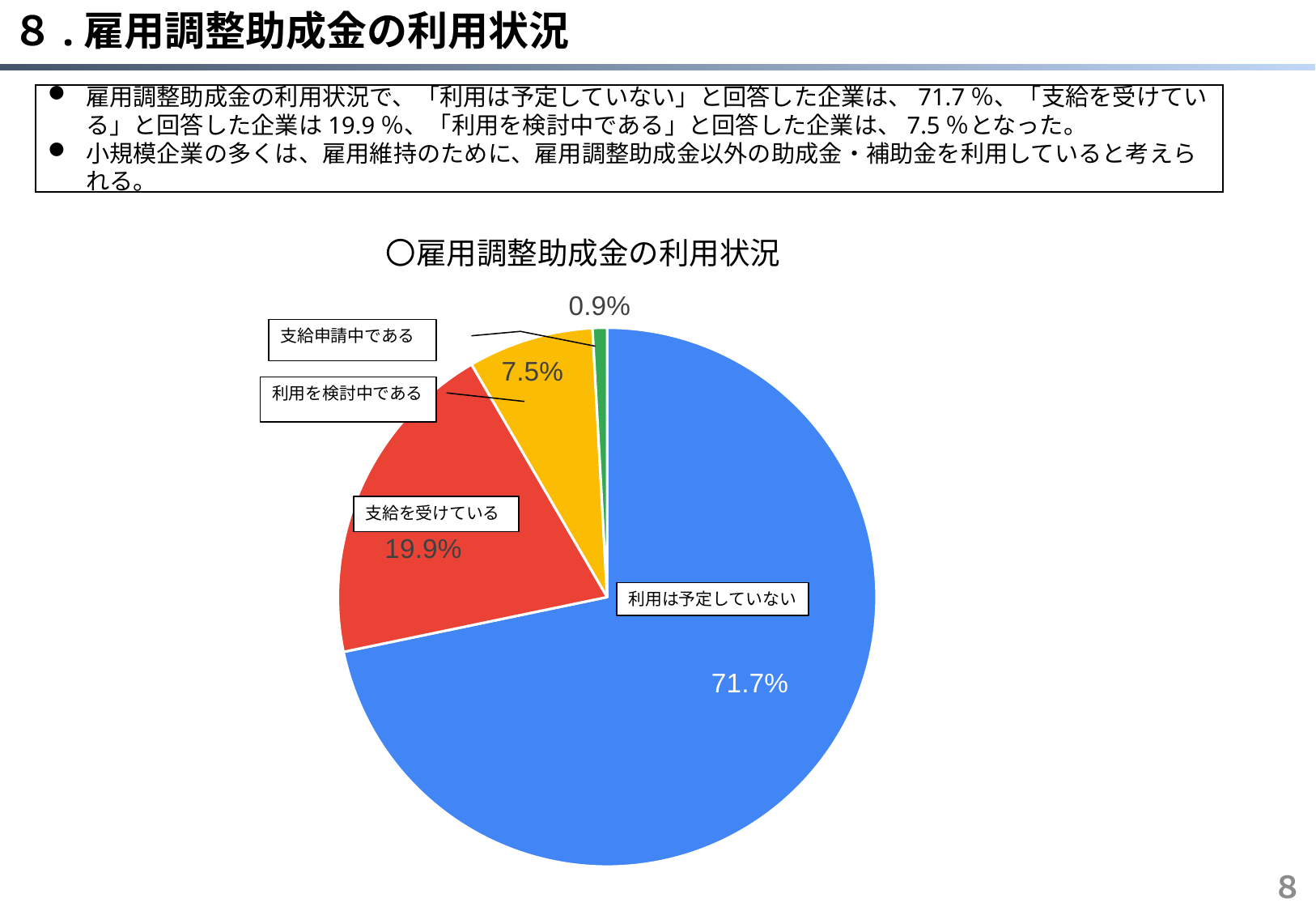
What percentage of companies answered 「支給申請中である」? 0.9% What percentage of companies answered 「利用は予定していない」? 71.7% Which category has the smallest share of the pie? 支給申請中である What colour is the slice for 「支給を受けている」? red Which category has the largest share of the pie? 利用は予定していない What type of chart is shown on the slide? pie chart What is the difference in percentage points between 「利用は予定していない」 and 「支給を受けている」? 51.8 What percentage of companies answered 「利用を検討中である」? 7.5% Which is larger, the share for 「支給を受けている」 or the share for 「利用を検討中である」? 支給を受けている What is the title of the pie chart? 〇雇用調整助成金の利用状況 How many slices does the pie chart have? 4 What percentage of companies answered 「支給を受けている」? 19.9%